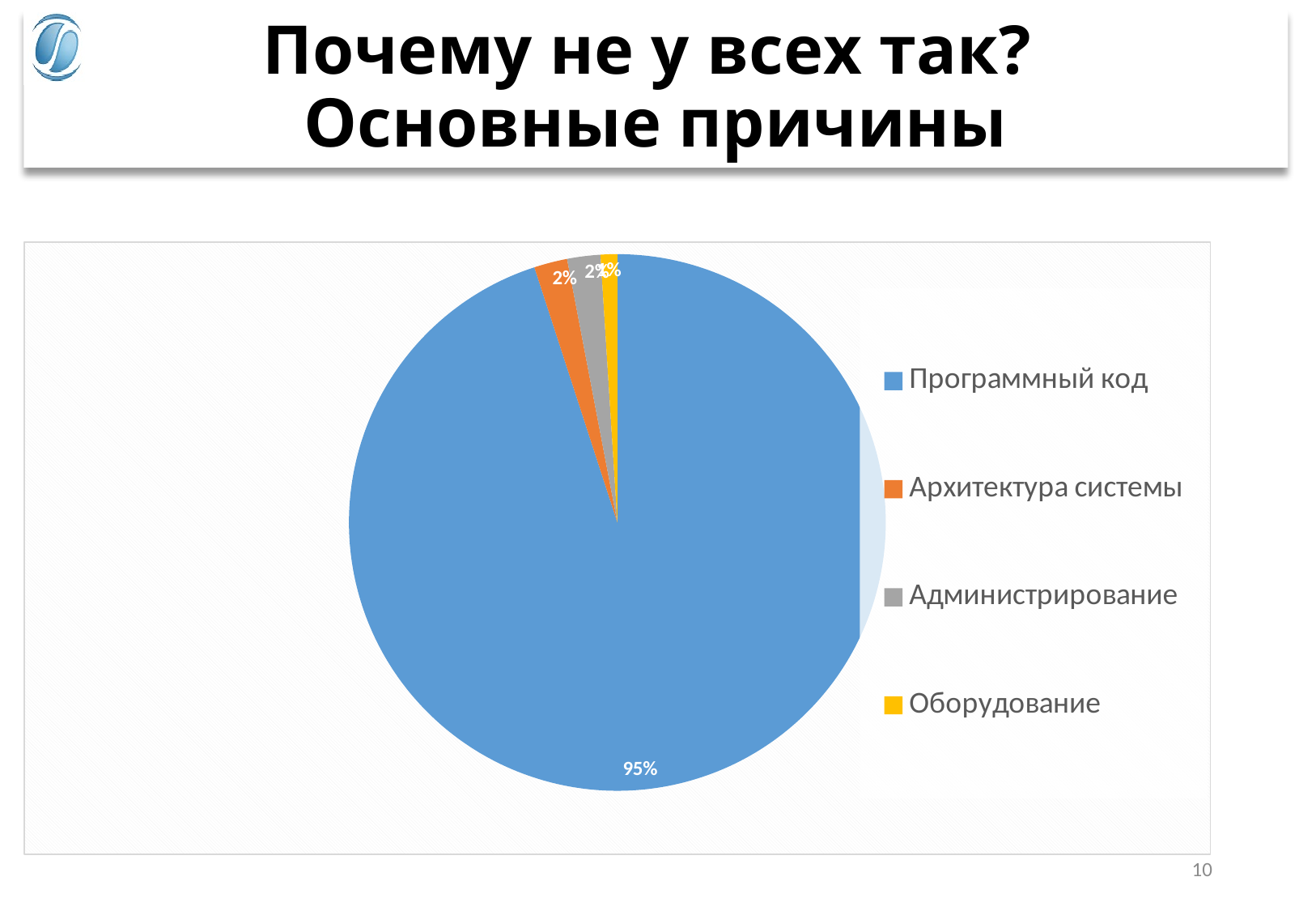
What kind of chart is shown on the slide? Pie chart What share of the pie does Архитектура системы have? 2% What share of the pie does Программный код have? 95% How many entries does the legend list? 4 What is the difference in percentage points between the share for Программный код and the share for Администрирование? 93% Which category has the largest share of the pie? Программный код Which is larger: the share for Программный код or the share for Архитектура системы? Программный код How many categories does the pie chart show? 4 Which category is shown in yellow in the legend? Оборудование What colour is the slice for Программный код? Blue What share of the pie does Администрирование have? 2%